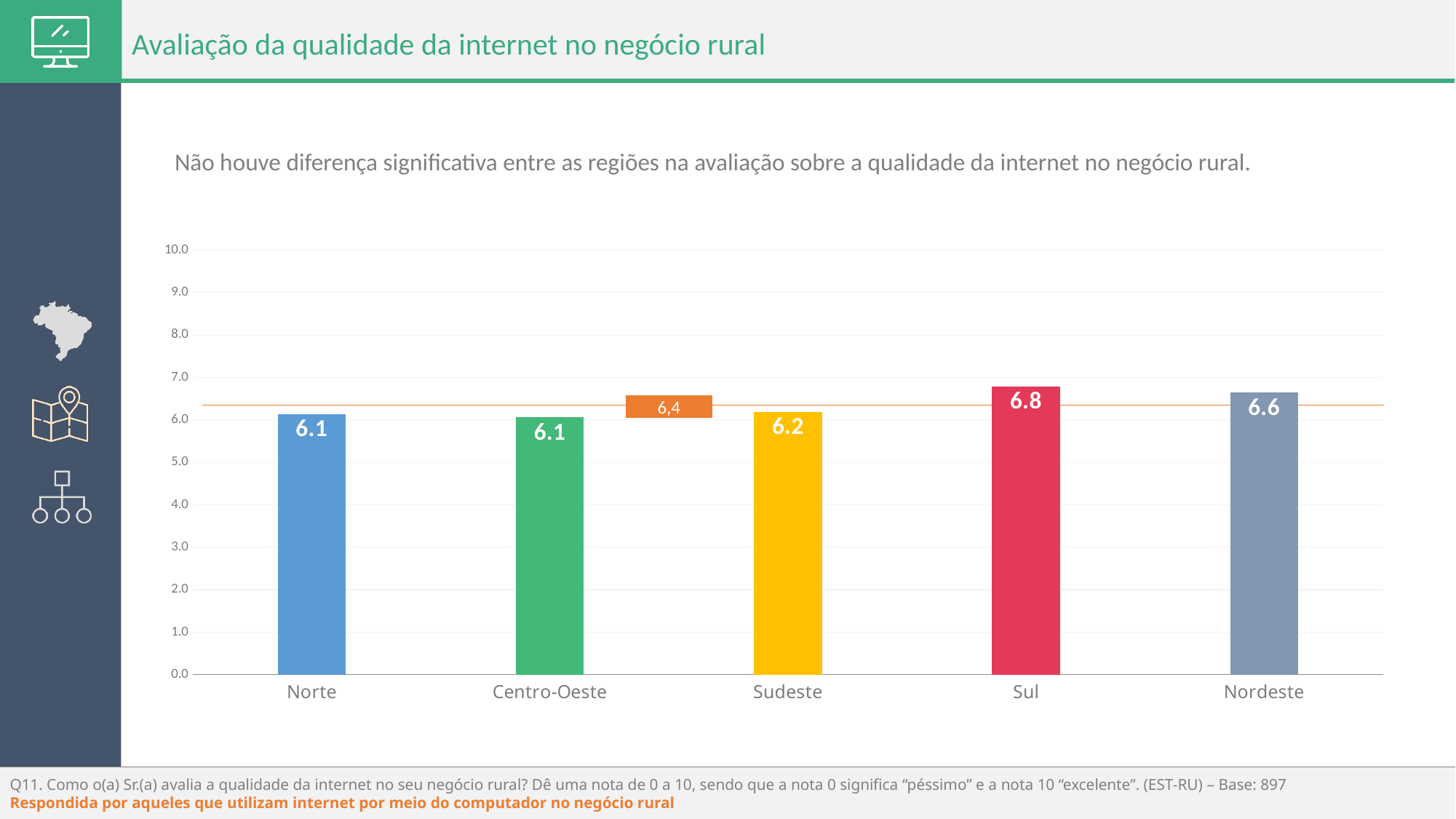
How many regions are shown on the x axis? 5 What is the value for Norte? 6.1 Which region has the highest value? Sul What is the value for Sul? 6.8 What kind of chart is shown on the slide? bar chart Which is larger, the value for Sul or the value for Nordeste? Sul Is the value for Sul greater or less than 7.0? less What value is labelled on the horizontal orange reference line? 6,4 What is the value for Sudeste? 6.2 What is the difference between the values for Nordeste and Centro-Oeste? 0.5 What is the value for Nordeste? 6.6 What is the difference between the values for Sul and Sudeste? 0.6